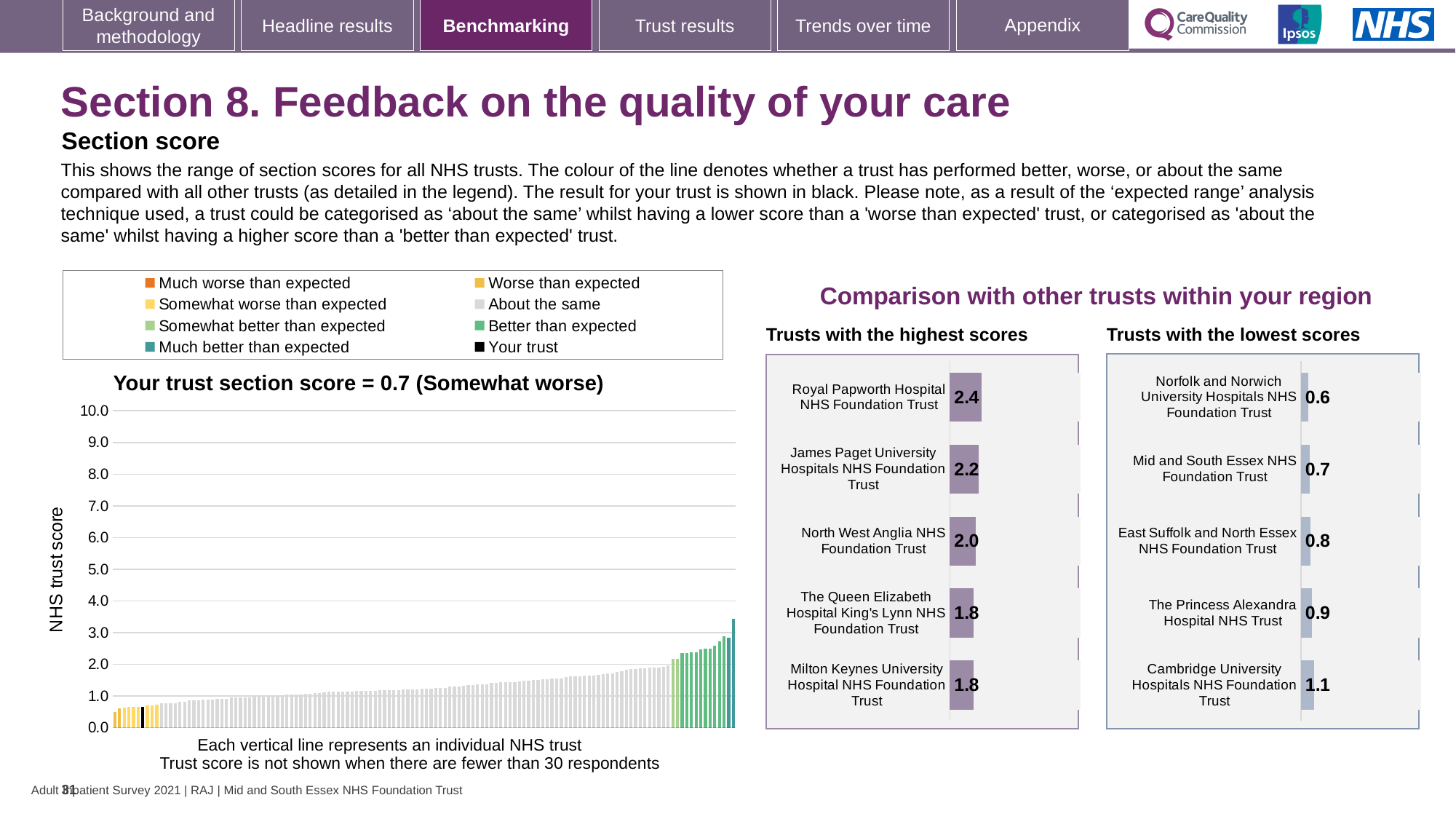
In the 'Trusts with the highest scores' chart, what is the score for Royal Papworth Hospital NHS Foundation Trust? 2.4 In the 'Your trust section score' chart, what is the section score for your trust? 0.7 In the 'Trusts with the highest scores' chart, how many trusts are shown? 5 In the 'Your trust section score' chart, what is the highest value shown on the y axis? 10.0 In the 'Trusts with the lowest scores' chart, which has the larger score: The Princess Alexandra Hospital NHS Trust or East Suffolk and North Essex NHS Foundation Trust? The Princess Alexandra Hospital NHS Trust How many entries does the legend above the 'Your trust section score' chart list? 8 What kind of chart is the 'Your trust section score' chart? bar chart In the 'Your trust section score' chart, do the bars rise or fall from left to right? rise In the 'Trusts with the lowest scores' chart, what is the score for Cambridge University Hospitals NHS Foundation Trust? 1.1 In the 'Your trust section score' chart, is the tallest bar greater or less than 4.0? less In the 'Trusts with the lowest scores' chart, which trust has the lowest score? Norfolk and Norwich University Hospitals NHS Foundation Trust In the 'Trusts with the highest scores' chart, what is the difference between the scores of Royal Papworth Hospital NHS Foundation Trust and North West Anglia NHS Foundation Trust? 0.4